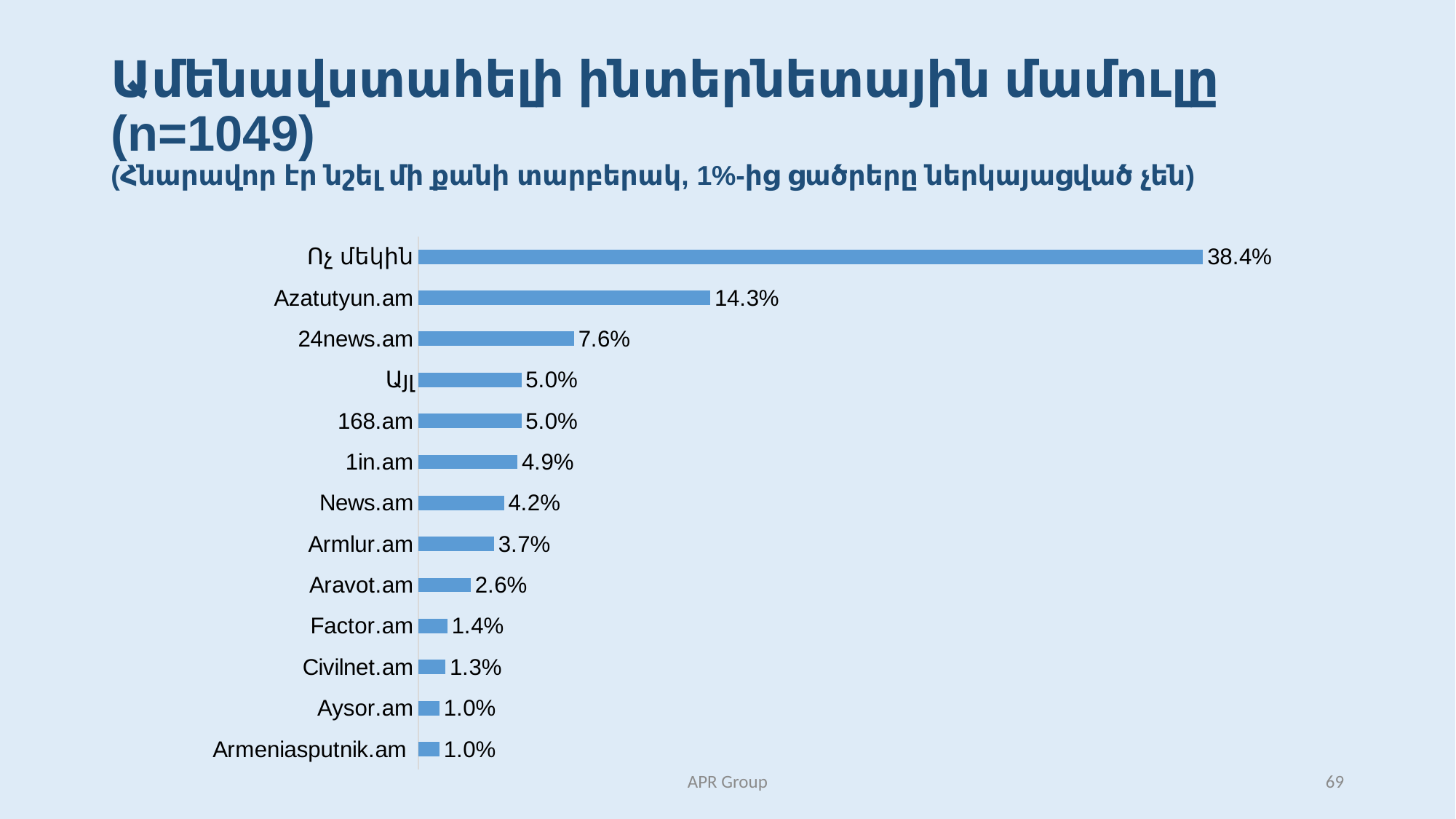
Which category has the highest value? Ոչ մեկին What is the difference between the values for News.am and Aravot.am? 1.6% Which is larger, the value for 1in.am or the value for Factor.am? 1in.am How many categories are shown in the chart? 13 What is the value for 24news.am? 7.6% What kind of chart is shown on the slide? Bar chart What is the value for Civilnet.am? 1.3% Which is larger, the value for Azatutyun.am or the value for 168.am? Azatutyun.am What is the value for Azatutyun.am? 14.3% What is the sample size (n) stated in the slide title? 1049 What is the value for Armlur.am? 3.7% What is the difference between the values for Azatutyun.am and 24news.am? 6.7%